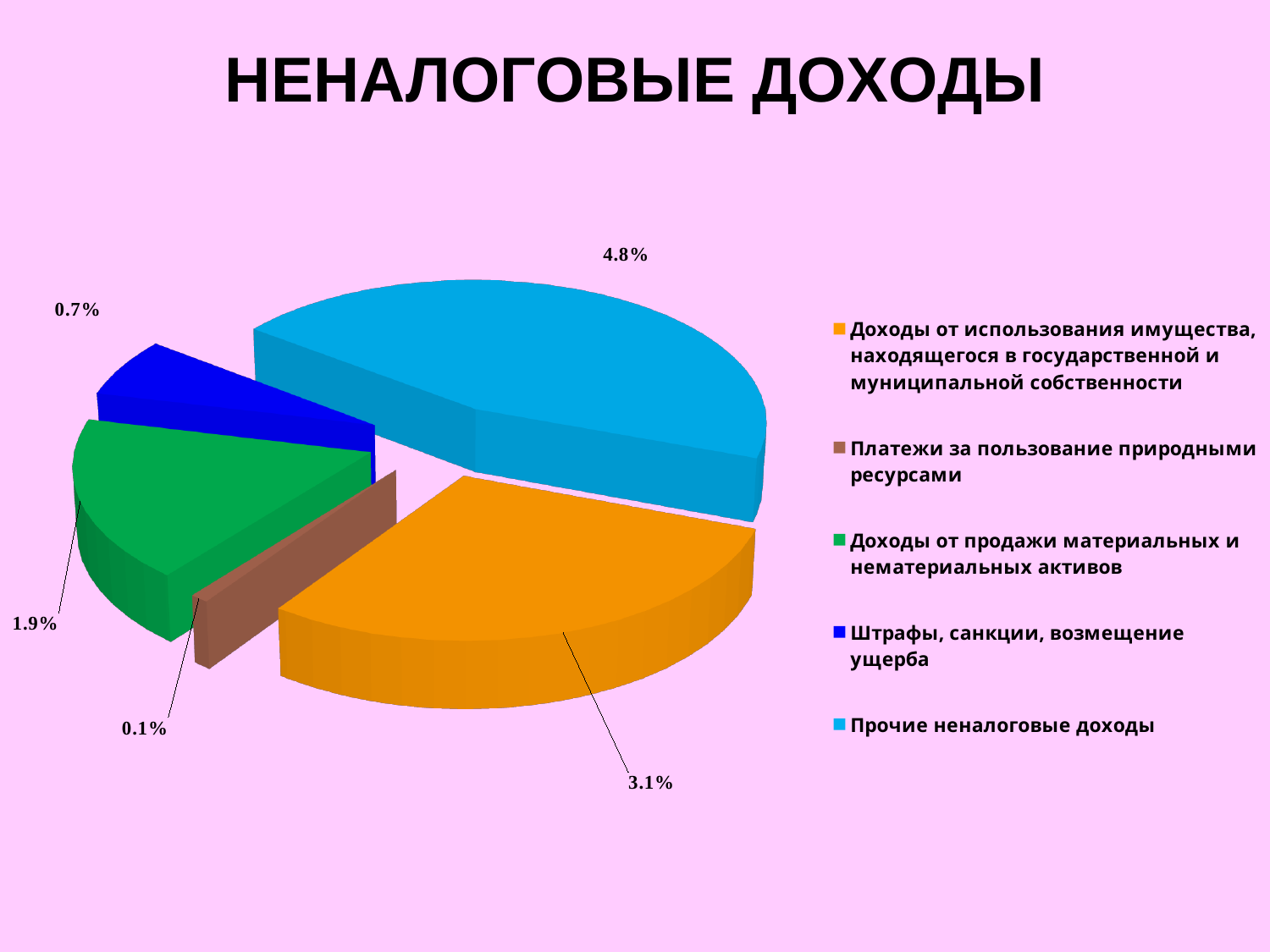
What value is shown for Штрафы, санкции, возмещение ущерба? 0.7% Which category has the largest slice of the pie? Прочие неналоговые доходы How many categories does the legend list? 5 What is the difference between the values for Прочие неналоговые доходы and Доходы от использования имущества, находящегося в государственной и муниципальной собственности? 1.7% What value is shown for Платежи за пользование природными ресурсами? 0.1% What value is shown for Прочие неналоговые доходы? 4.8% What value is shown for Доходы от продажи материальных и нематериальных активов? 1.9% Which is larger: the value for Доходы от продажи материальных и нематериальных активов or the value for Штрафы, санкции, возмещение ущерба? Доходы от продажи материальных и нематериальных активов What value is shown for Доходы от использования имущества, находящегося в государственной и муниципальной собственности? 3.1% What kind of chart is shown on the slide? pie chart Which category has the smallest slice of the pie? Платежи за пользование природными ресурсами What is the title of the slide? НЕНАЛОГОВЫЕ ДОХОДЫ